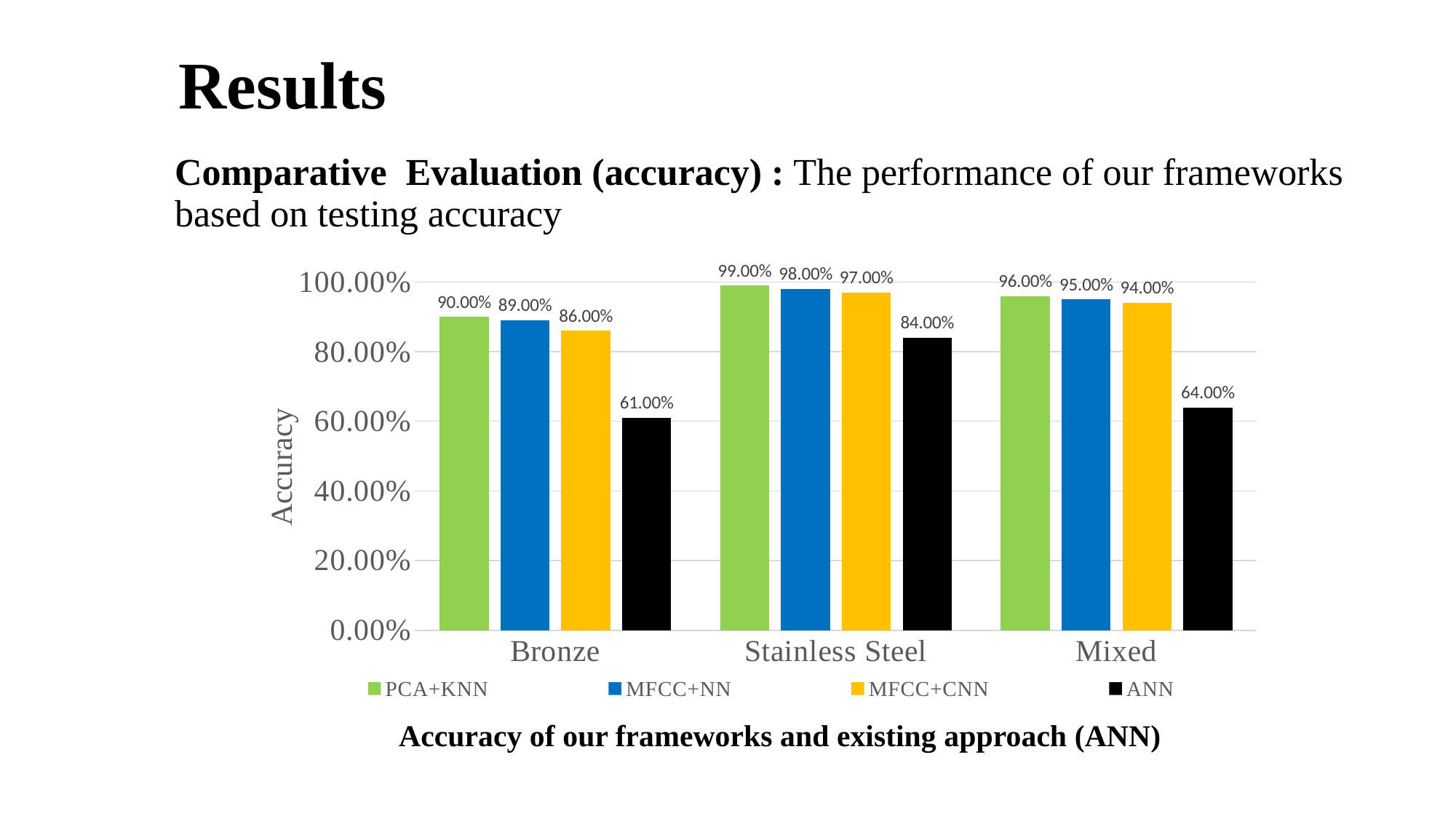
How many series does the legend list? 4 What colour represents the ANN series in the chart? Black What is the difference between the PCA+KNN and ANN accuracies for Bronze? 29.00% What is the accuracy of MFCC+CNN for Mixed? 94.00% Which category has the highest PCA+KNN accuracy? Stainless Steel What kind of chart is shown on the slide? Bar chart What is the accuracy of ANN for Stainless Steel? 84.00% What is the accuracy of PCA+KNN for Bronze? 90.00% Which is larger: the ANN accuracy for Mixed or the ANN accuracy for Bronze? Mixed How many categories are shown on the x axis? 3 What is the difference between the MFCC+NN accuracies for Stainless Steel and Mixed? 3.00% Which category has the lowest ANN accuracy? Bronze